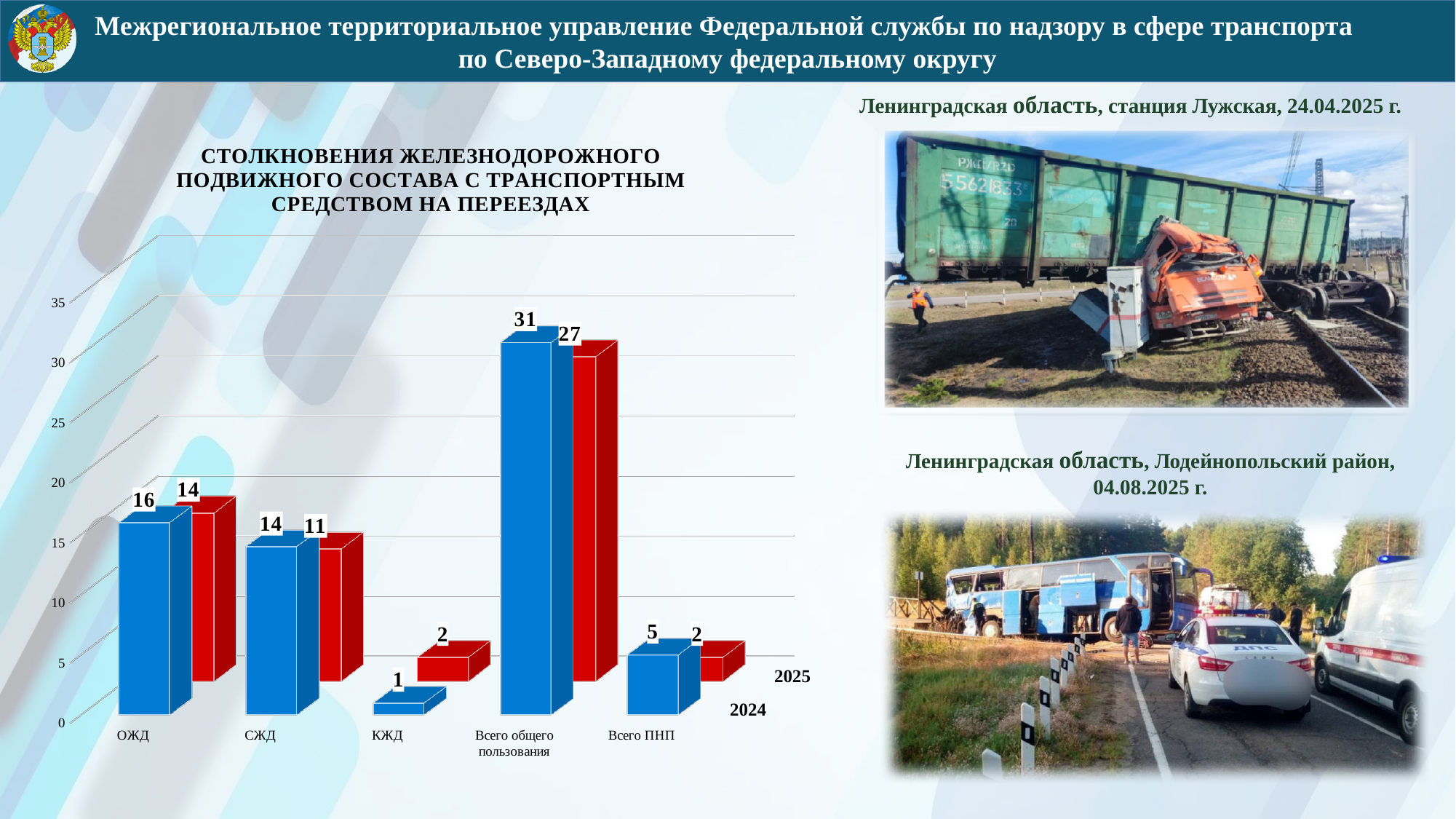
What is the difference between the 2024 and 2025 values for Всего общего пользования? 4 Which colour represents the 2025 series? red What is the value for Всего общего пользования in 2025? 27 What is the value for Всего ПНП in 2024? 5 Which category has the lowest value in 2024? КЖД Which is larger for КЖД: the 2024 value or the 2025 value? 2025 Is the value for ОЖД in 2024 greater or less than 15? greater What is the value for ОЖД in 2024? 16 How many categories are shown on the x axis? 5 What is the value for СЖД in 2025? 11 What kind of chart is shown on the slide? bar chart Which category has the highest value in 2024? Всего общего пользования